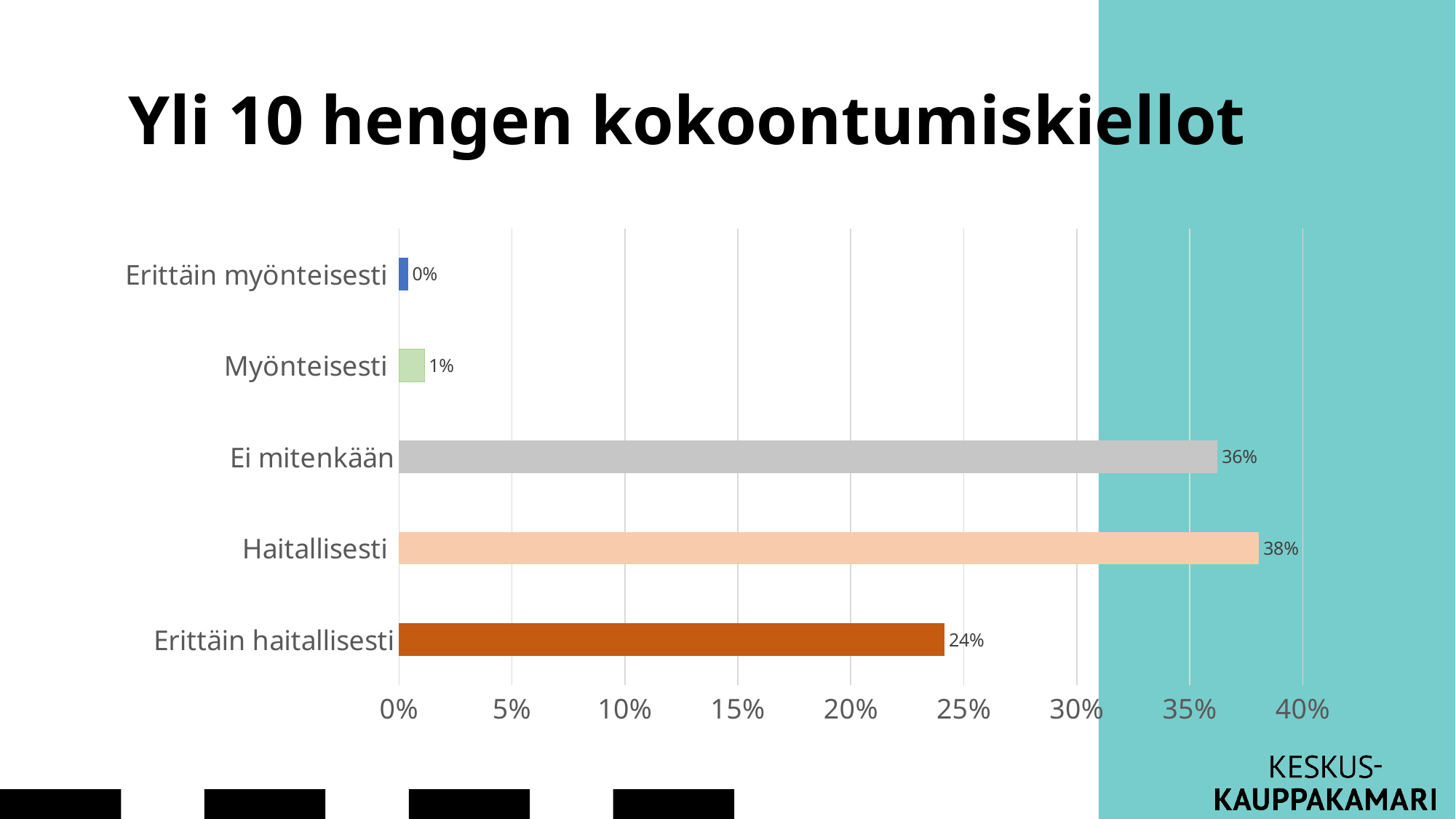
What is the value for Ei mitenkään? 36% What kind of chart is shown on the slide? Bar chart Which is larger, the value for Ei mitenkään or the value for Erittäin haitallisesti? Ei mitenkään What is the value for Myönteisesti? 1% What is the value for Erittäin myönteisesti? 0% What is the value for Erittäin haitallisesti? 24% Which category has the lowest value? Erittäin myönteisesti Which category has the highest value? Haitallisesti How many categories are shown in the chart? 5 What is the difference between the values for Haitallisesti and Erittäin haitallisesti? 14% What is the title of the slide? Yli 10 hengen kokoontumiskiellot What is the value for Haitallisesti? 38%